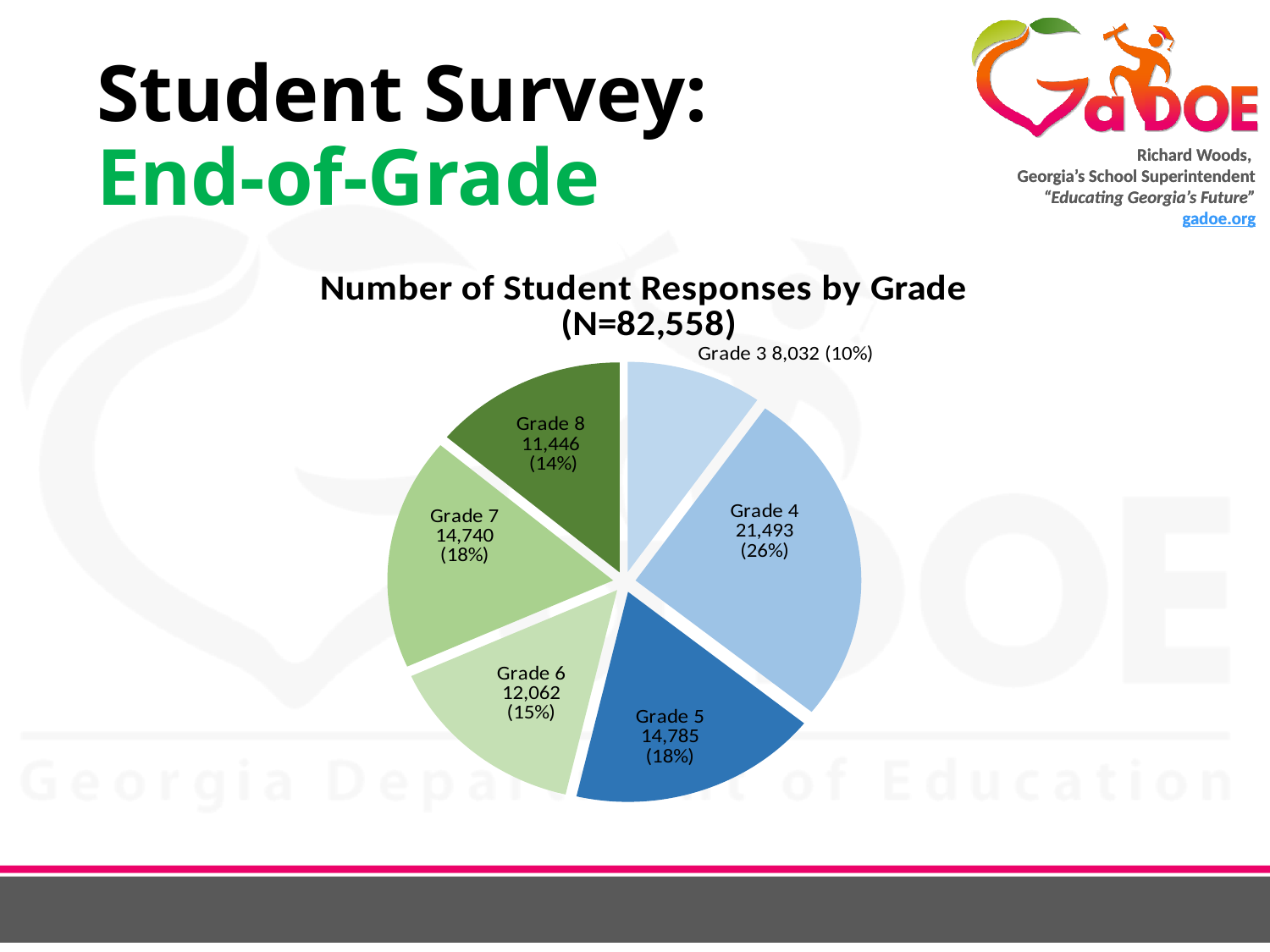
Which grade has the largest number of student responses? Grade 4 What share of the student responses came from Grade 4? 26% What is the title of the chart? Number of Student Responses by Grade (N=82,558) How many student responses were there for Grade 4? 21,493 How many student responses were there for Grade 8? 11,446 What is the difference in the number of responses between Grade 4 and Grade 3? 13,461 Which has more student responses, Grade 4 or Grade 8? Grade 4 How many student responses were there for Grade 3? 8,032 How many grades are shown as slices in the pie chart? 6 Which grade has the smallest number of student responses? Grade 3 What kind of chart is shown on the slide? Pie chart What share of the student responses came from Grade 6? 15%